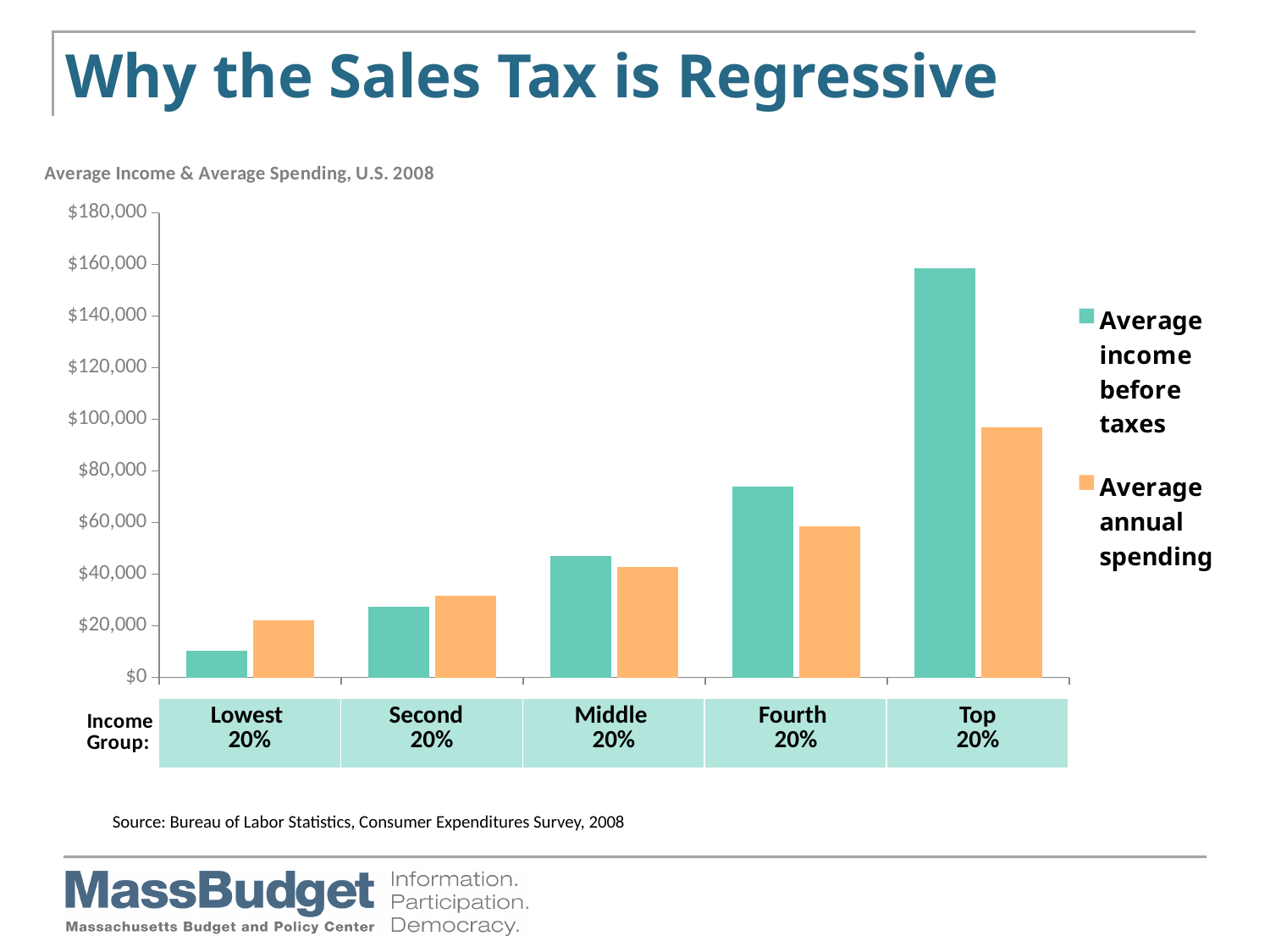
For the Lowest 20% income group, which is larger: average income before taxes or average annual spending? Average annual spending What kind of chart is shown on the slide? bar chart Is the average annual spending for the Top 20% greater or less than $100,000? less Does average income before taxes rise or fall from the Lowest 20% to the Top 20% income group? rise Is the average income before taxes for the Lowest 20% greater or less than $20,000? less How many income groups are shown on the x axis? 5 How many series does the legend list? 2 Which income group has the lowest average annual spending? Lowest 20% Is the average income before taxes for the Top 20% greater or less than $140,000? greater Which income group has the highest average income before taxes? Top 20% For the Top 20% income group, which is larger: average income before taxes or average annual spending? Average income before taxes